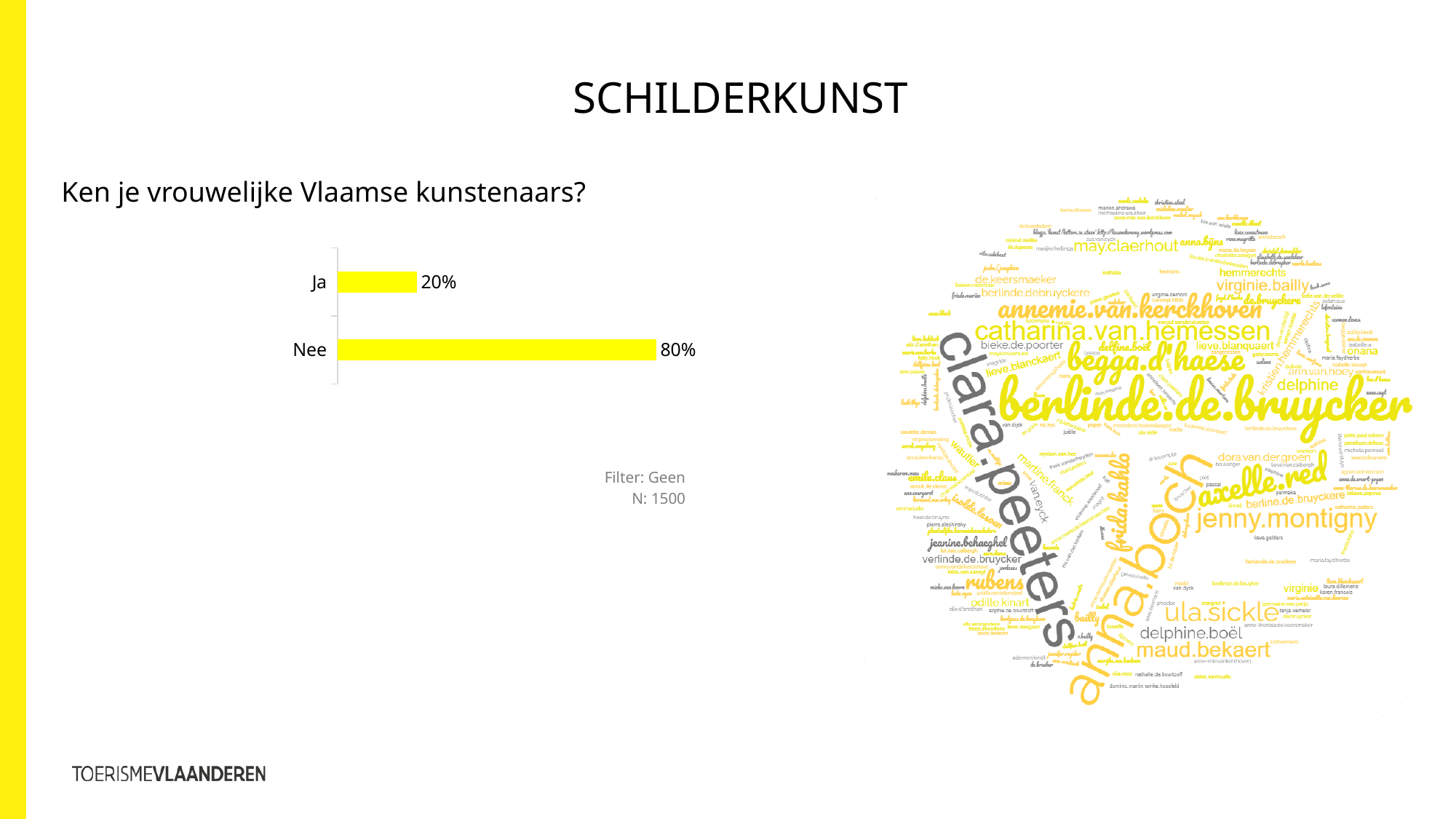
What type of chart is used to show the answers to 'Ken je vrouwelijke Vlaamse kunstenaars?' Bar chart What is the difference in percentage points between the 'Nee' and 'Ja' bars? 60 How many answer categories are shown in the bar chart? 2 What is the sample size (N) stated below the bar chart? 1500 Which is larger, the value for 'Ja' or the value for 'Nee'? Nee Which answer category has the highest value in the bar chart? Nee What percentage of respondents answered 'Nee' to the question 'Ken je vrouwelijke Vlaamse kunstenaars?' 80% What percentage of respondents answered 'Ja' to the question 'Ken je vrouwelijke Vlaamse kunstenaars?' 20% What colour are the bars in the bar chart? Yellow Which answer category has the lowest value in the bar chart? Ja What is the total of the 'Ja' and 'Nee' percentages in the bar chart? 100%